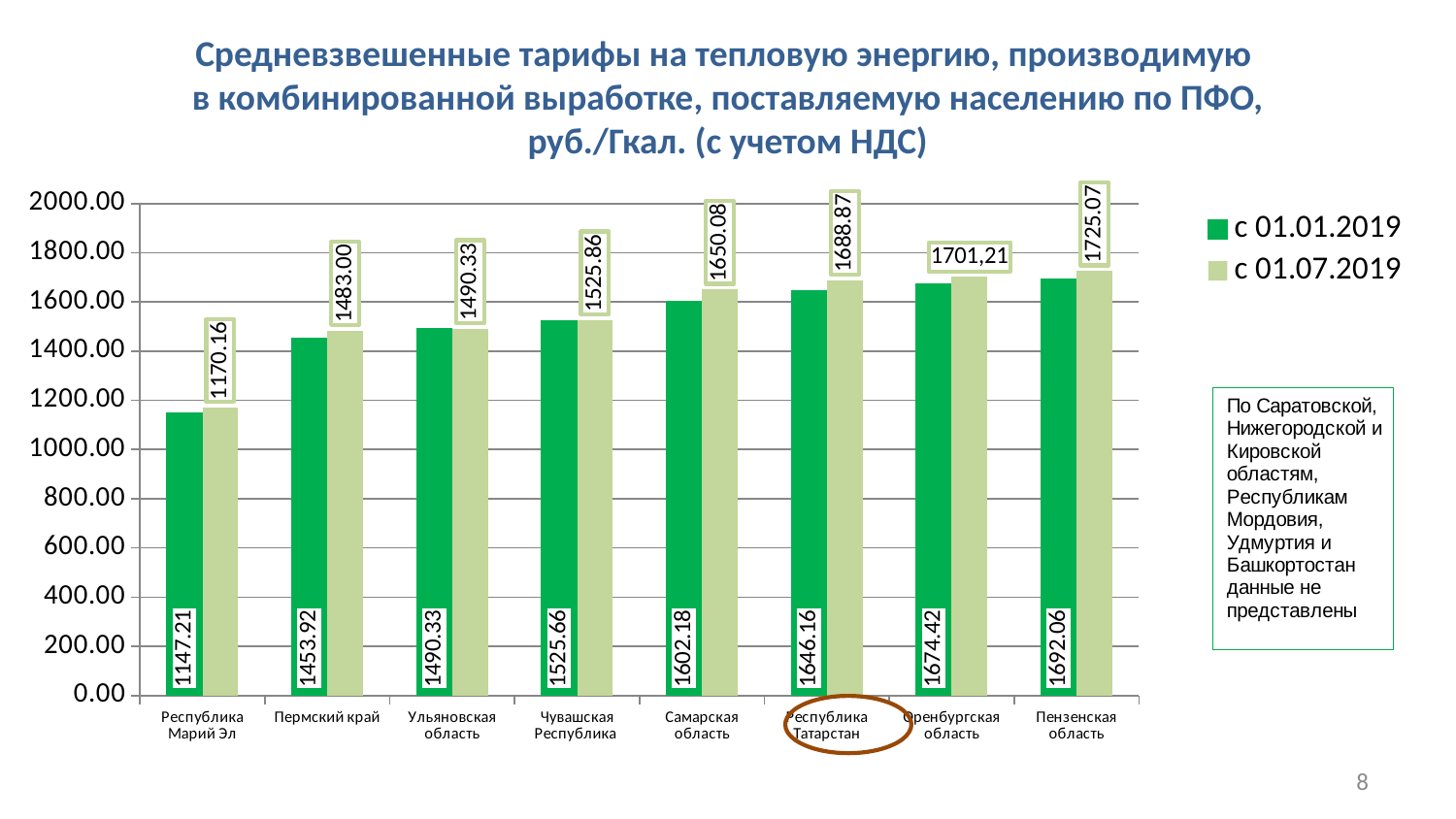
Which category has the highest value in the с 01.07.2019 series? Пензенская область How many categories (regions) are shown on the x axis? 8 What is the difference between the с 01.07.2019 and с 01.01.2019 values for Пензенская область? 33.01 What is the value for Самарская область in the с 01.07.2019 series? 1650.08 What is the value for Республика Татарстан in the с 01.01.2019 series? 1646.16 Do the values in the с 01.01.2019 series rise or fall from left to right along the x axis? Rise What is the difference between the с 01.07.2019 and с 01.01.2019 values for Республика Татарстан? 42.71 Which is larger in the с 01.01.2019 series: Республика Марий Эл or Пермский край? Пермский край Which category has the lowest value in the с 01.01.2019 series? Республика Марий Эл What kind of chart is shown on the slide? Bar chart How many series does the legend list? 2 What is the value for Пензенская область in the с 01.07.2019 series? 1725.07